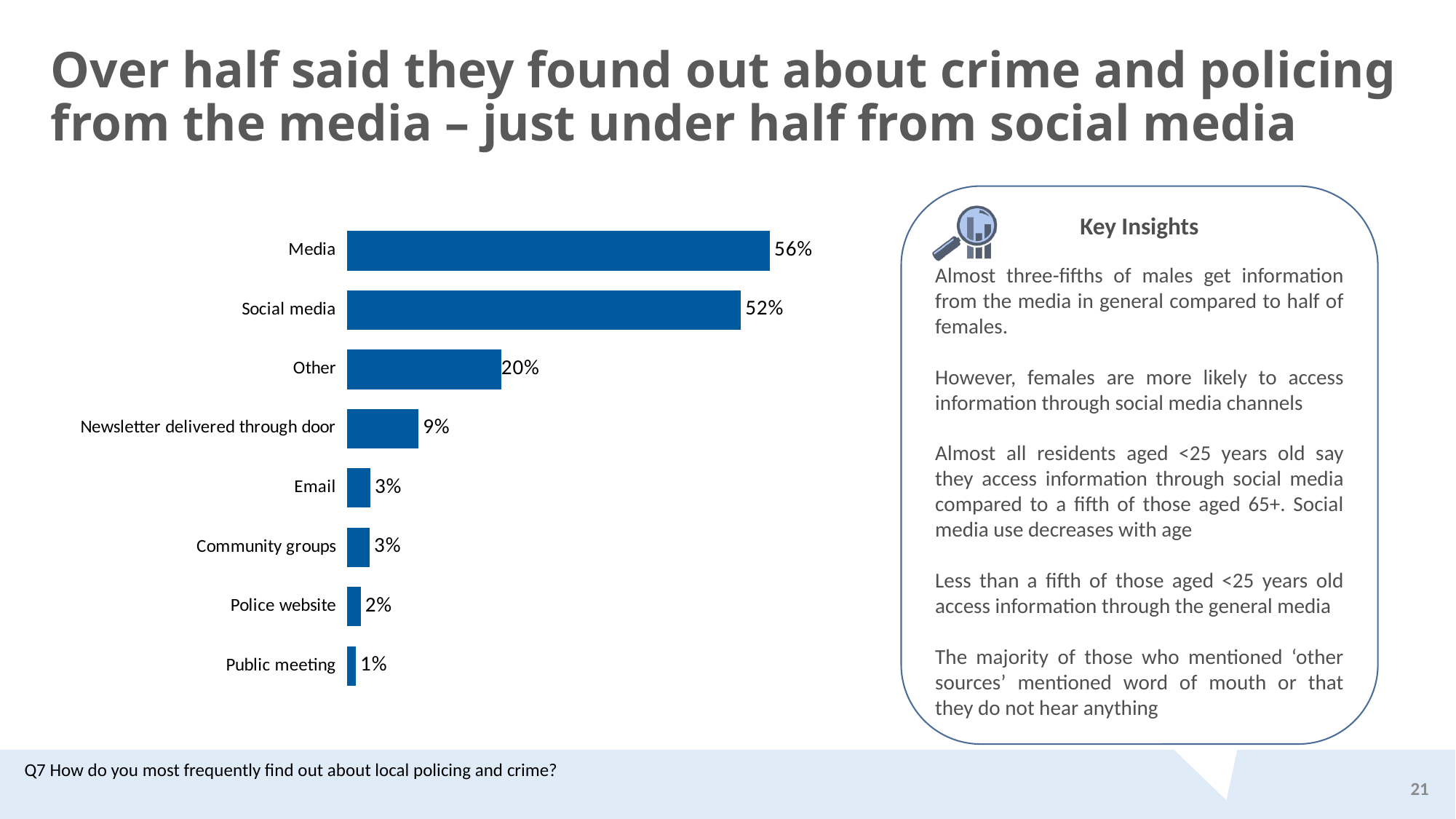
What is the difference between the values for Other and Newsletter delivered through door? 11 percentage points What is the value shown for Social media? 52% What percentage of respondents said they find out about local policing and crime from the media? 56% What is the value for Police website? 2% What is the difference between the values for Media and Social media? 4 percentage points What survey question is the chart based on, as shown at the bottom of the slide? Q7 How do you most frequently find out about local policing and crime? Which category has the lowest value? Public meeting How many categories are shown in the chart? 8 Which category has the highest value? Media What kind of chart is shown on the slide? Bar chart What percentage is shown for Newsletter delivered through door? 9% Which is larger, the value for Other or the value for Email? Other